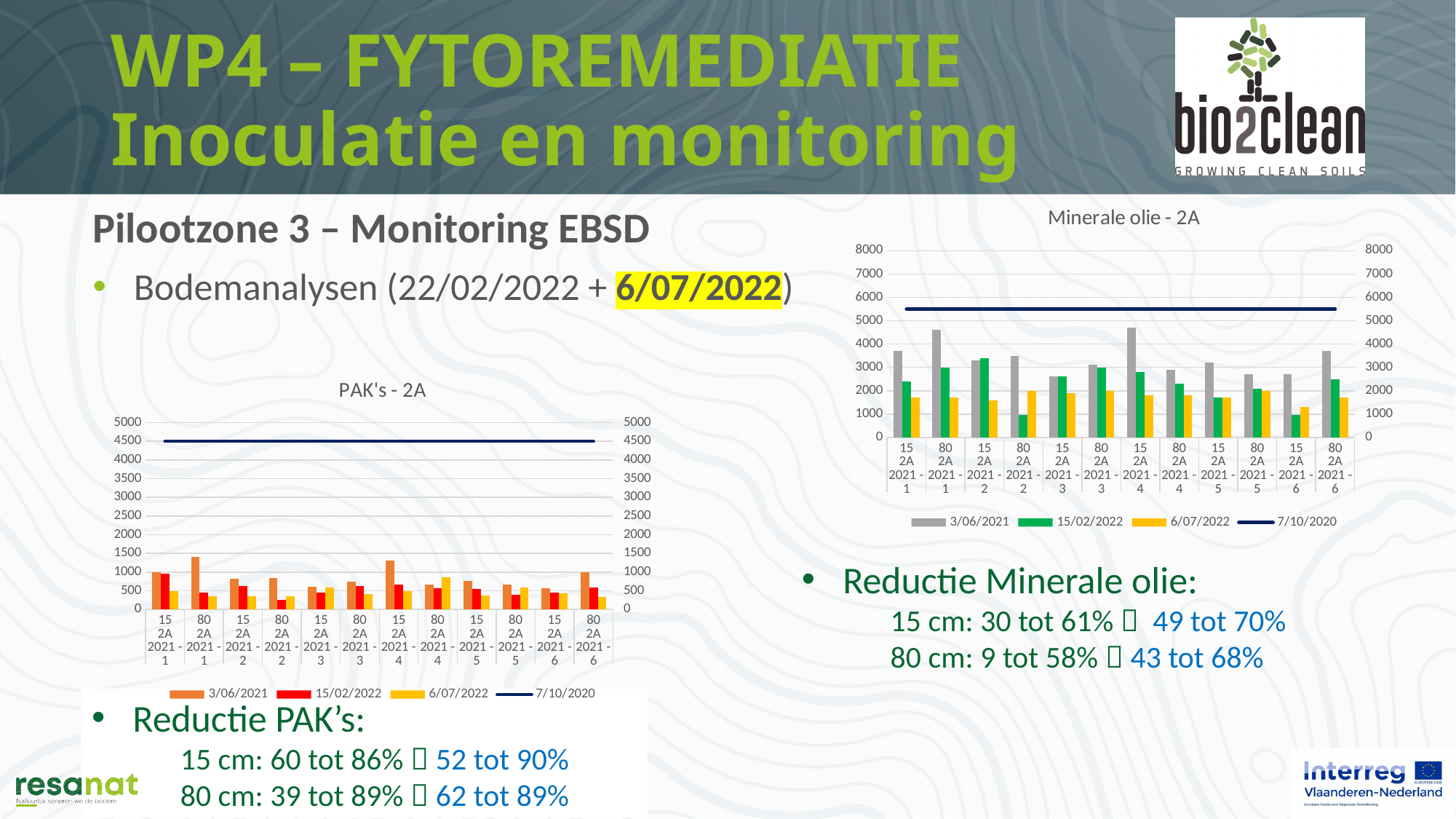
In the 'PAK's - 2A' chart, which category has the highest 3/06/2021 bar? 80 2A 2021 - 1 What is the highest value shown on the vertical axis of the 'Minerale olie - 2A' chart? 8000 In the 'Minerale olie - 2A' chart, which series is drawn as a line rather than bars? 7/10/2020 How many series does the legend of the 'Minerale olie - 2A' chart list? 4 In the 'Minerale olie - 2A' chart, is the 3/06/2021 value for '15 2A 2021 - 1' greater or less than 3000? greater How many categories are shown on the x axis of the 'PAK's - 2A' chart? 12 In the 'PAK's - 2A' chart, for '80 2A 2021 - 1', which series has the larger value: 3/06/2021 or 6/07/2022? 3/06/2021 In the 'Minerale olie - 2A' chart, for '15 2A 2021 - 1', which series has the larger value: 3/06/2021 or 6/07/2022? 3/06/2021 What kind of chart is the 'PAK's - 2A' chart? combination bar and line chart In the 'PAK's - 2A' chart, is the 15/02/2022 value for '80 2A 2021 - 2' greater or less than 500? less In the 'PAK's - 2A' chart, is the 3/06/2021 value for '80 2A 2021 - 1' greater or less than 1000? greater